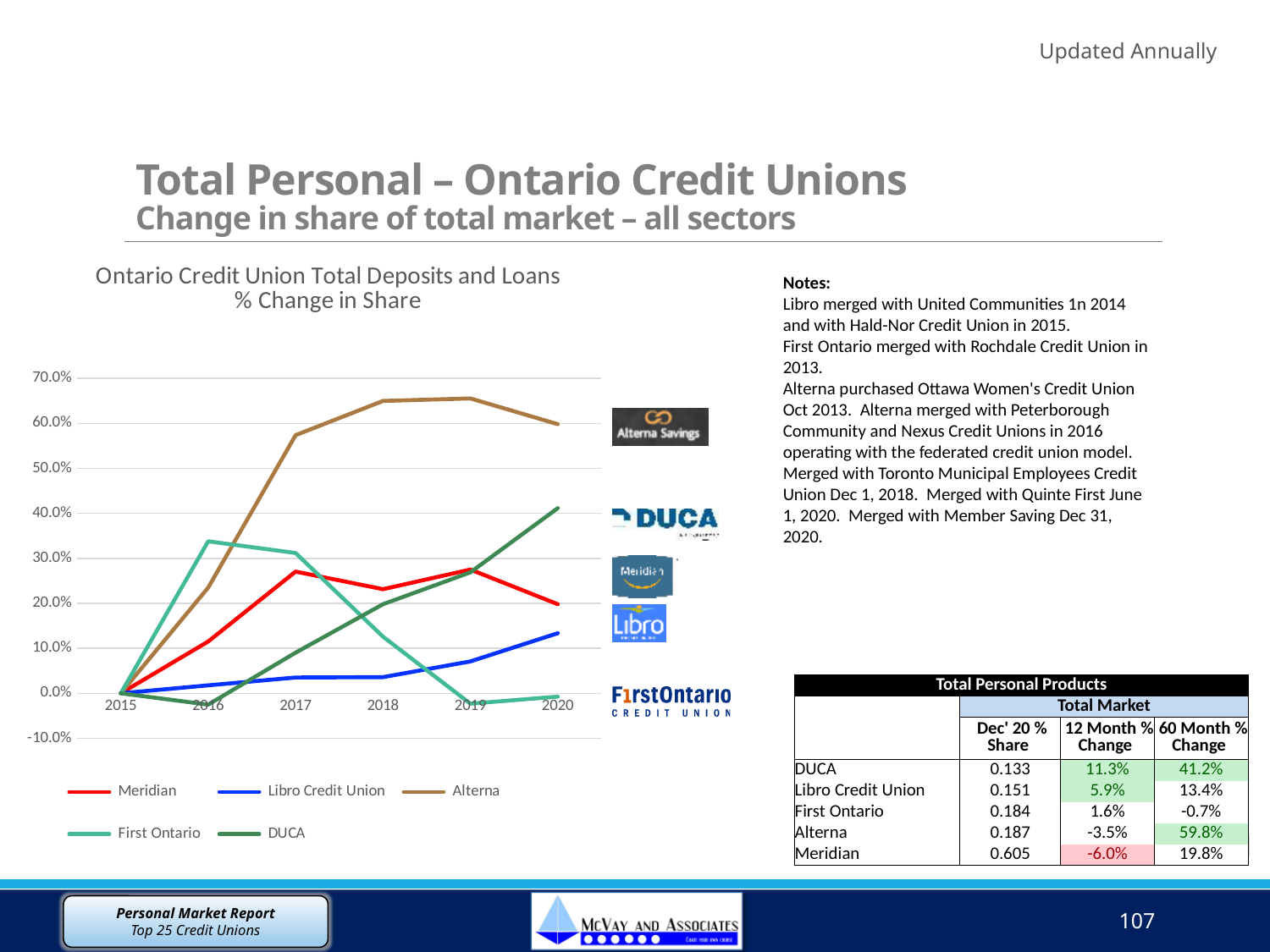
Is the value for Meridian in 2017 greater or less than 20.0%? greater Which credit union has the highest value in 2020? Alterna What kind of chart is shown on the slide? line chart Is the value for Alterna in 2018 greater or less than 60.0%? greater In 2016, which is larger: the value for First Ontario or the value for Alterna? First Ontario What is the title of the chart? Ontario Credit Union Total Deposits and Loans % Change in Share How many years are plotted along the x axis of the chart? 6 Is the value for DUCA in 2020 greater or less than 30.0%? greater How many series does the chart's legend list? 5 Does the Alterna line rise or fall from 2015 to 2018? rise Which credit union has the highest value in 2016? First Ontario Which credit union has the lowest value in 2020? First Ontario